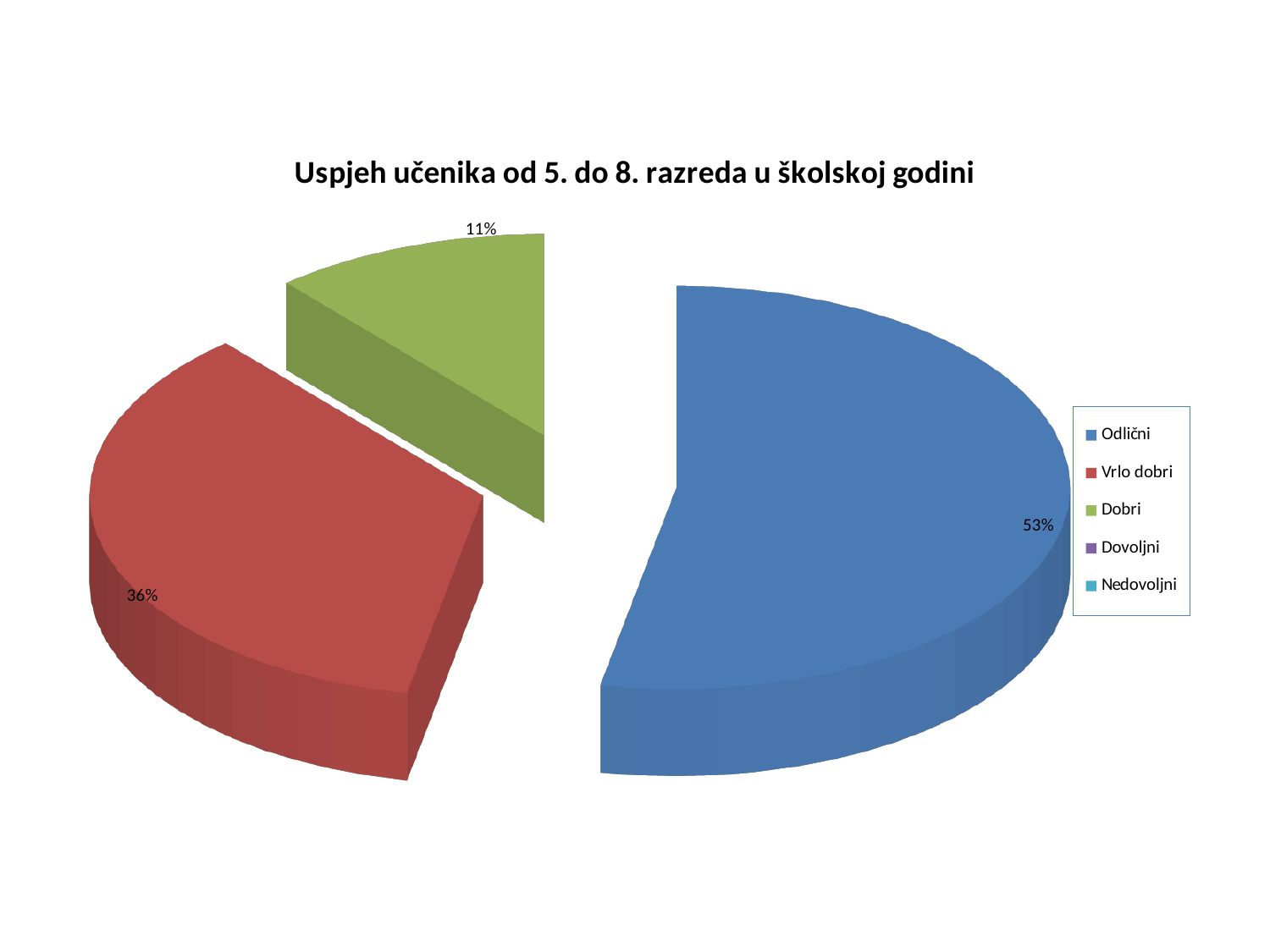
Which is larger, the slice for Vrlo dobri or the slice for Dobri? Vrlo dobri What is the difference in percentage points between Odlični and Vrlo dobri? 17% What share of the pie does Odlični represent? 53% What share of the pie does Vrlo dobri represent? 36% What share of the pie does Dobri represent? 11% What colour is the slice for Odlični? Blue How many categories does the legend list? 5 What is the difference in percentage points between Vrlo dobri and Dobri? 25% What is the title of the chart? Uspjeh učenika od 5. do 8. razreda u školskoj godini Which of the three labelled slices is the smallest? Dobri Which category has the largest slice of the pie? Odlični What kind of chart is shown on the slide? Pie chart